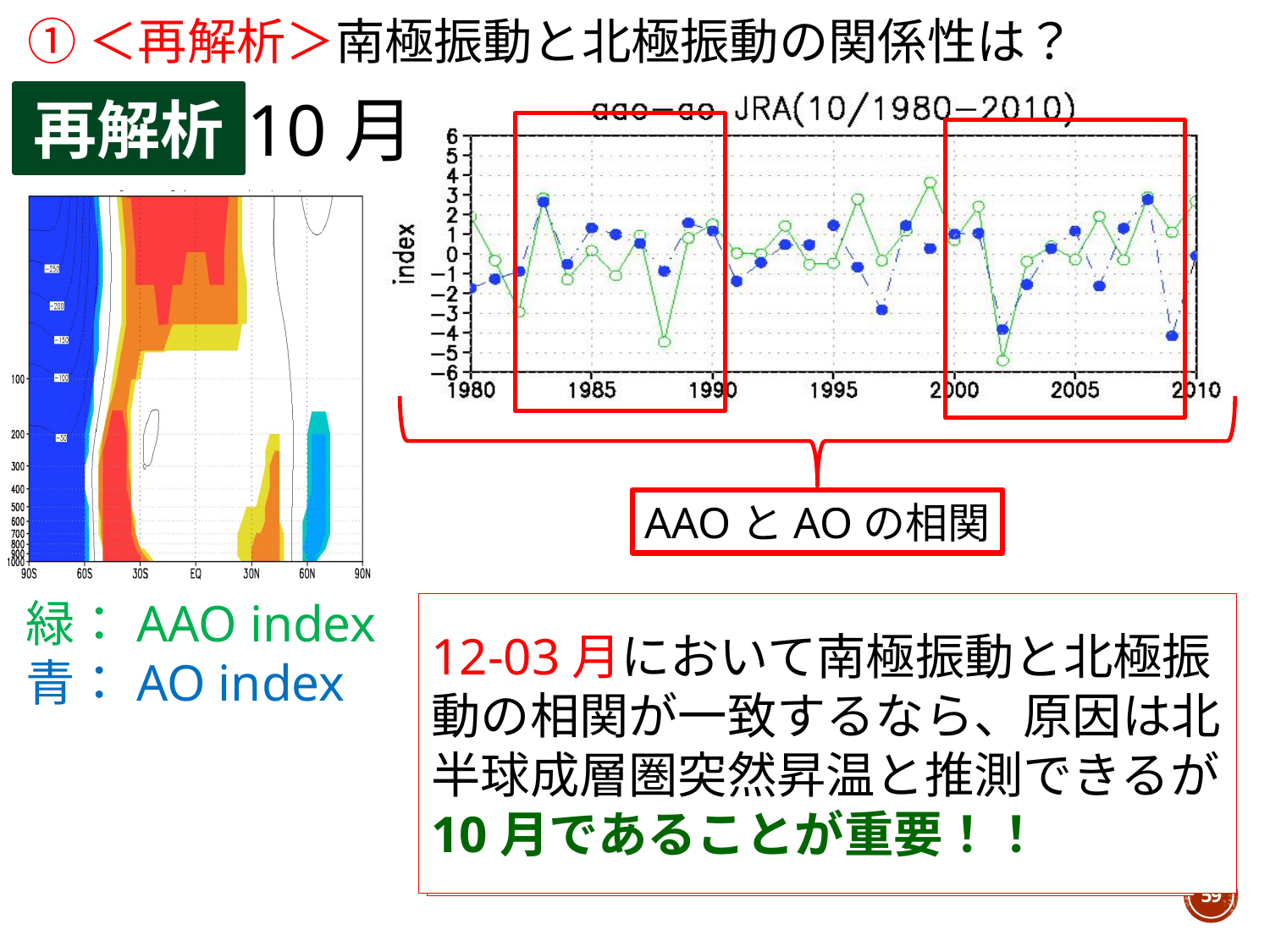
In the 'aao-ao JRA(10/1980-2010)' chart, in which year does the green AAO index reach its lowest value? 2002 In the 'aao-ao JRA(10/1980-2010)' chart, which is larger: the green AAO index value in 1999 or the green AAO index value in 1988? 1999 What kind of chart is the 'aao-ao JRA(10/1980-2010)' chart on the right of the slide? line chart In the 'aao-ao JRA(10/1980-2010)' chart, is the blue AO index value for 1983 greater or less than 2? greater In the 'aao-ao JRA(10/1980-2010)' chart, which colour represents the AAO index? green How many data series are plotted in the 'aao-ao JRA(10/1980-2010)' line chart? 2 What is the label on the y axis of the 'aao-ao JRA(10/1980-2010)' chart? index In the 'aao-ao JRA(10/1980-2010)' chart, is the green AAO index value for 2002 greater or less than -4? less In the 'aao-ao JRA(10/1980-2010)' chart, is the green AAO index value for 1988 greater or less than -3? less In the 'aao-ao JRA(10/1980-2010)' chart, in which year does the green AAO index reach its highest value? 1999